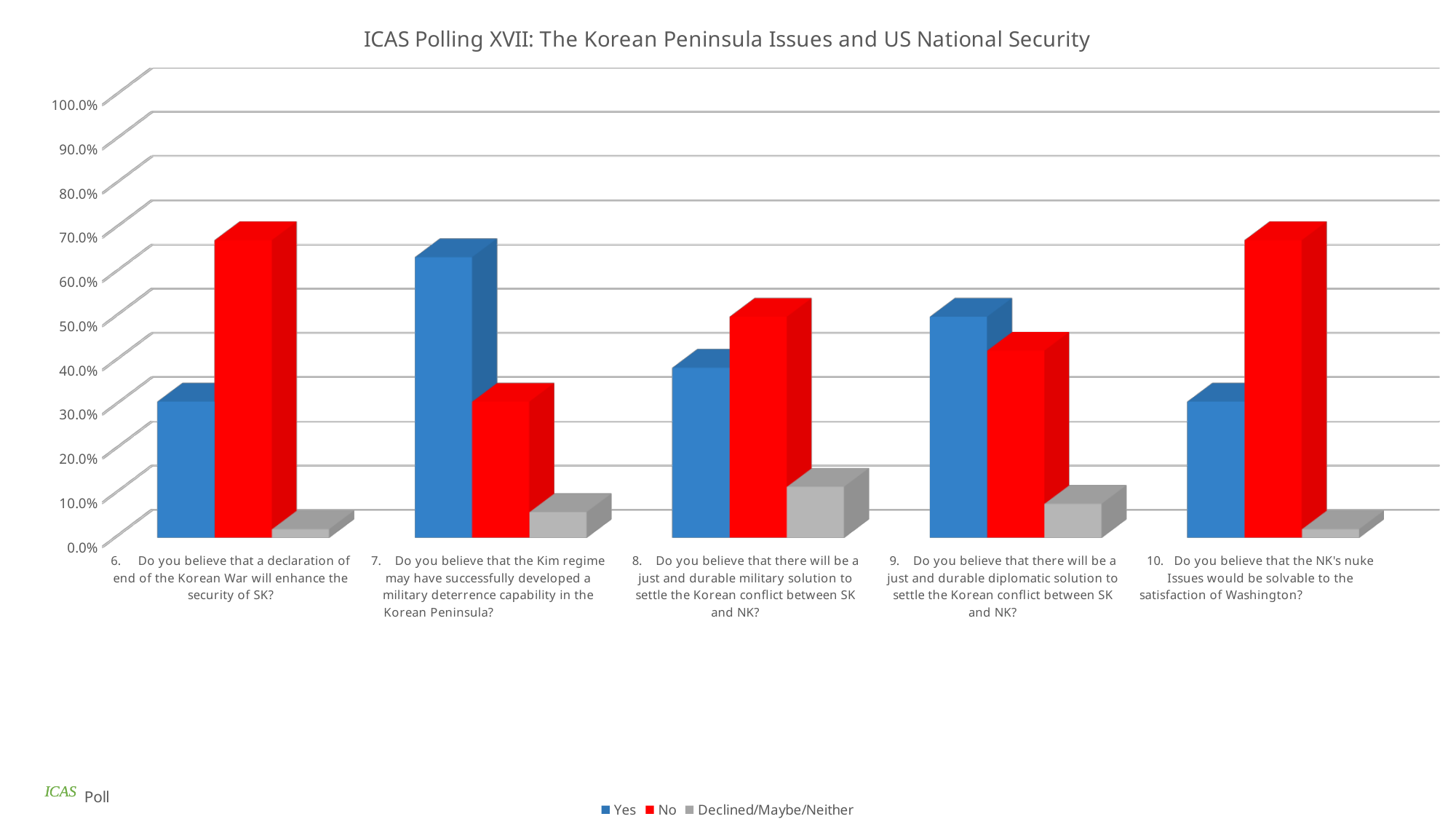
How many poll questions (categories) are plotted on the x axis? 5 For question 9 (just and durable diplomatic solution), which is larger, the "Yes" value or the "No" value? Yes Which poll question has the highest "Declined/Maybe/Neither" value? 8. Do you believe that there will be a just and durable military solution to settle the Korean conflict between SK and NK? Which colour represents the "No" series? red What is the title of the chart? ICAS Polling XVII: The Korean Peninsula Issues and US National Security Which poll question has the lowest "No" value? 7. Do you believe that the Kim regime may have successfully developed a military deterrence capability in the Korean Peninsula? What kind of chart is shown on the slide? bar chart Is the "No" value for question 6 (declaration of end of the Korean War) greater or less than 60.0%? greater Is the "Yes" value for question 10 (NK's nuke issues solvable to the satisfaction of Washington) greater or less than 40.0%? less Is the "Yes" value for question 7 (Kim regime military deterrence capability) greater or less than 60.0%? greater Which poll question has the highest "Yes" value? 7. Do you believe that the Kim regime may have successfully developed a military deterrence capability in the Korean Peninsula? How many series does the legend list? 3